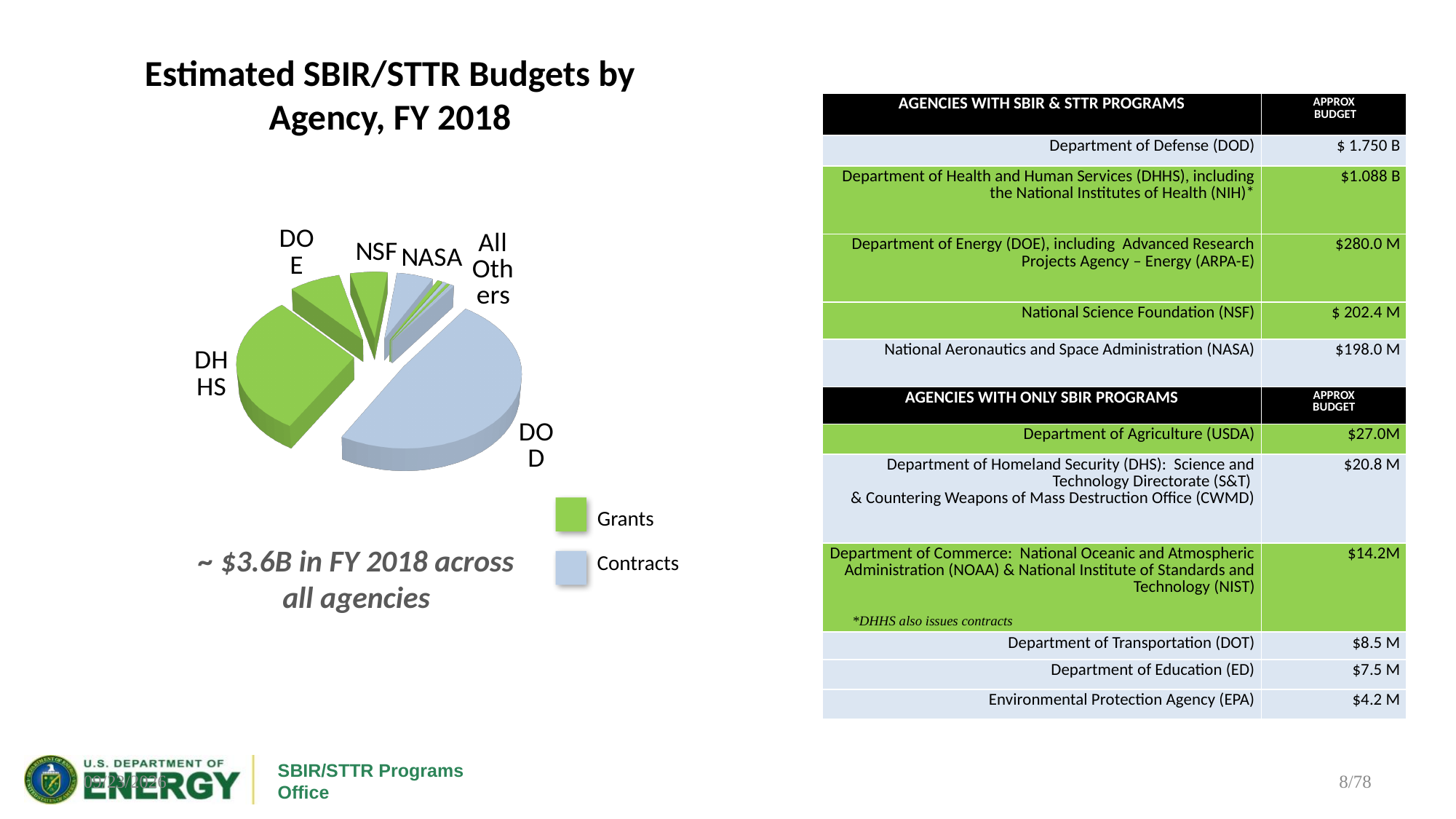
What is the title of the chart on the slide? Estimated SBIR/STTR Budgets by Agency, FY 2018 What kind of chart is shown on the slide? pie chart How many entries does the chart legend list? 2 According to the table on the slide, what is the approximate budget for the National Science Foundation (NSF)? $ 202.4 M Which slice is larger in the pie chart, DOD or DHHS? DOD Which slice is larger in the pie chart, DOE or NSF? DOE According to the table on the slide, what is the approximate budget for the Department of Energy (DOE)? $280.0 M According to the legend, what does the green colour in the pie chart represent? Grants According to the table on the slide, what is the approximate budget for the Department of Defense (DOD)? $ 1.750 B Which agency has the largest slice in the pie chart? DOD